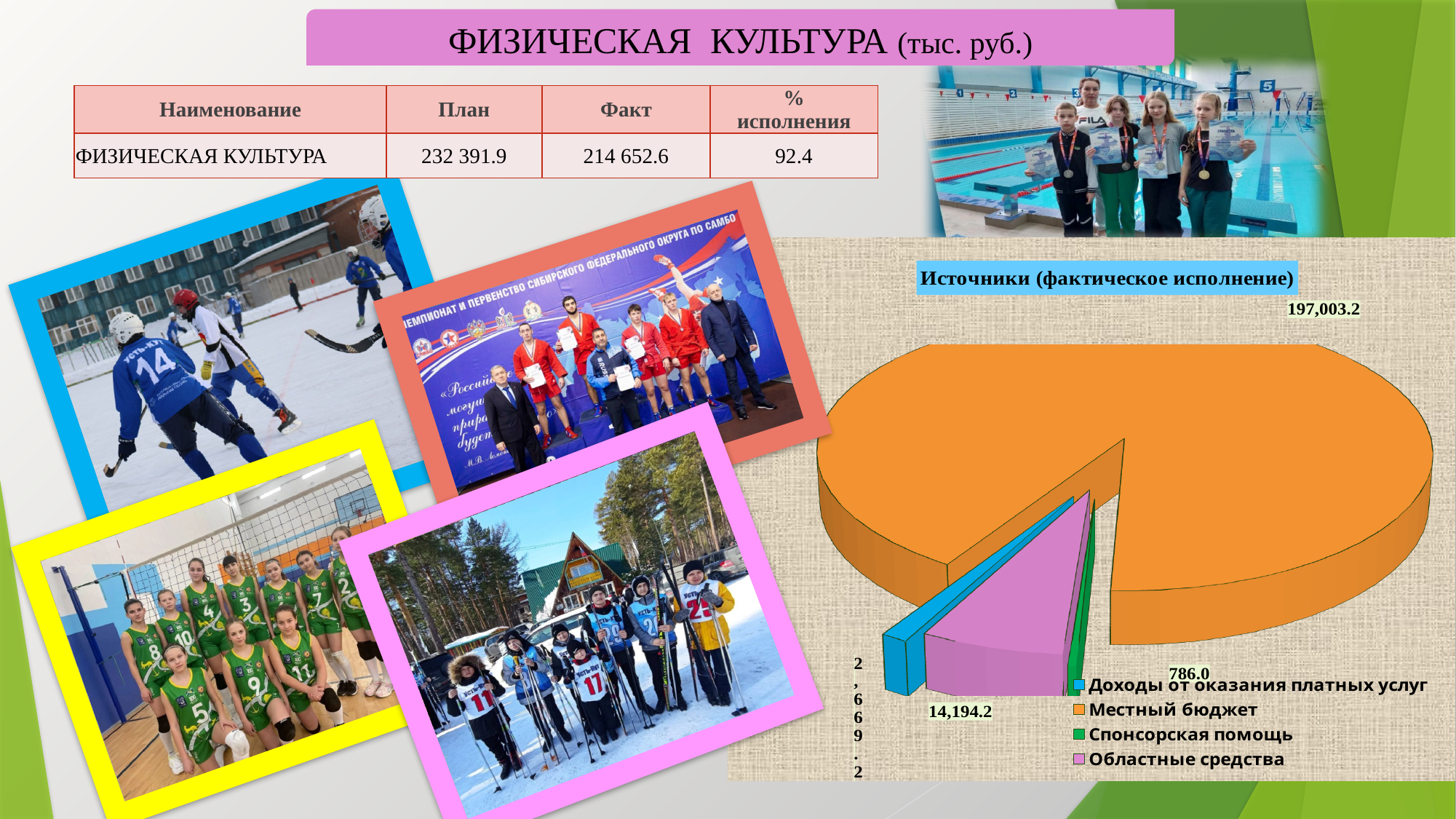
In the pie chart, what is the value for Доходы от оказания платных услуг? 2,669.2 How many slices does the pie chart have? 4 In the pie chart, which is larger: Областные средства or Доходы от оказания платных услуг? Областные средства In the pie chart, what is the value for Спонсорская помощь? 786.0 What colour is the Местный бюджет slice in the pie chart? orange What kind of chart is shown under the title "Источники (фактическое исполнение)"? pie chart In the pie chart, what is the value for Местный бюджет? 197,003.2 In the pie chart, what is the difference between Местный бюджет and Областные средства? 182,809.0 In the pie chart, what is the difference between Областные средства and Доходы от оказания платных услуг? 11,525.0 Which source has the largest slice in the pie chart? Местный бюджет In the pie chart, what is the value for Областные средства? 14,194.2 Which source has the smallest slice in the pie chart? Спонсорская помощь